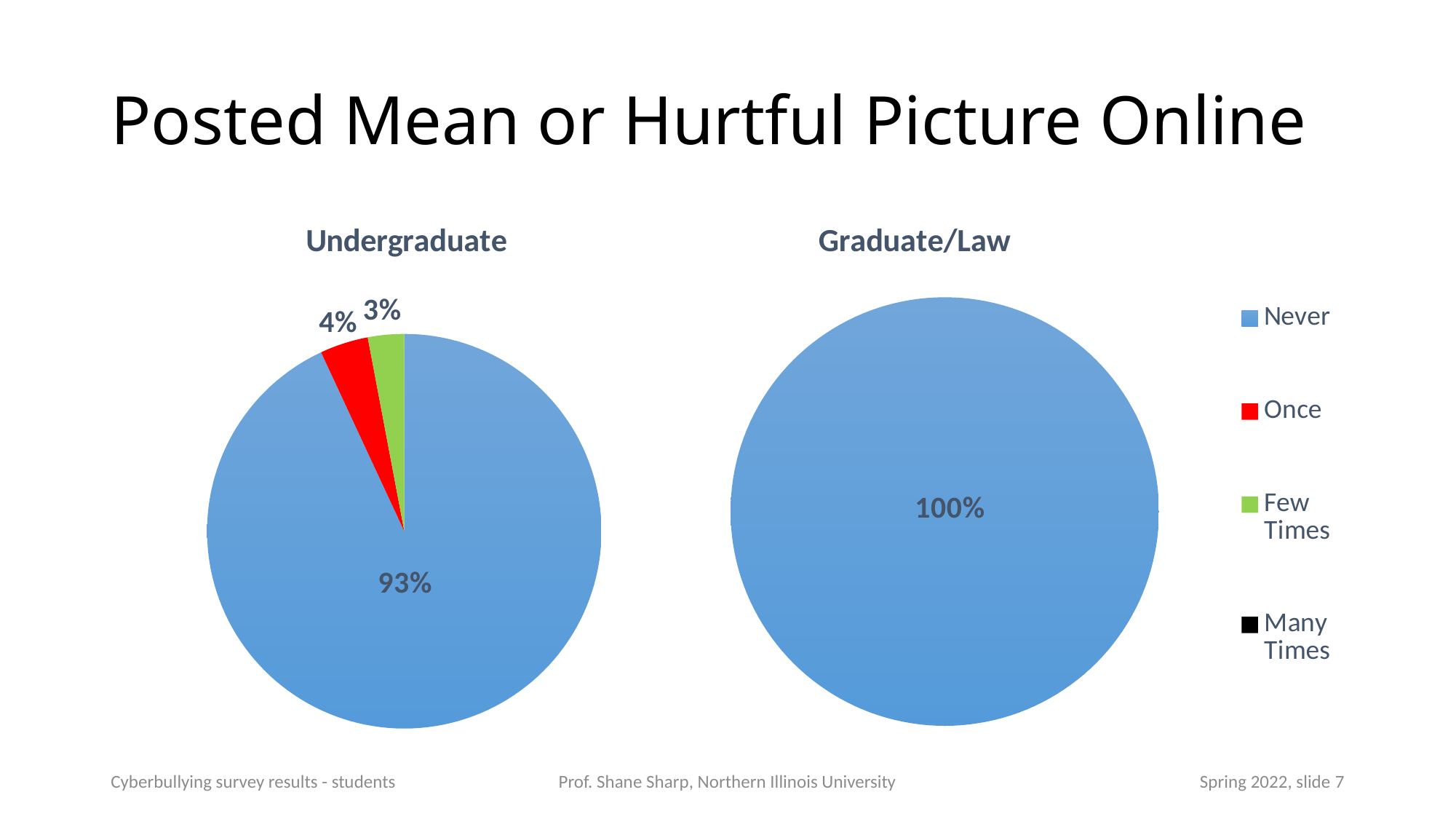
In the Undergraduate chart, what share of respondents answered Few Times? 3% In the Undergraduate chart, which category has the largest slice? Never In the Graduate/Law chart, what share of respondents answered Never? 100% In the Undergraduate chart, which of the labelled slices is the smallest? Few Times What colour represents the Once category in the legend? Red What is the title of the chart on the right? Graduate/Law In the Undergraduate chart, what is the difference between the Never share and the Once share? 89% In the Undergraduate chart, what share of respondents answered Never? 93% In the Undergraduate chart, what share of respondents answered Once? 4% In the Undergraduate chart, which is larger, the Once slice or the Few Times slice? Once How many entries does the legend list? 4 What kind of chart is used for the Undergraduate data? Pie chart